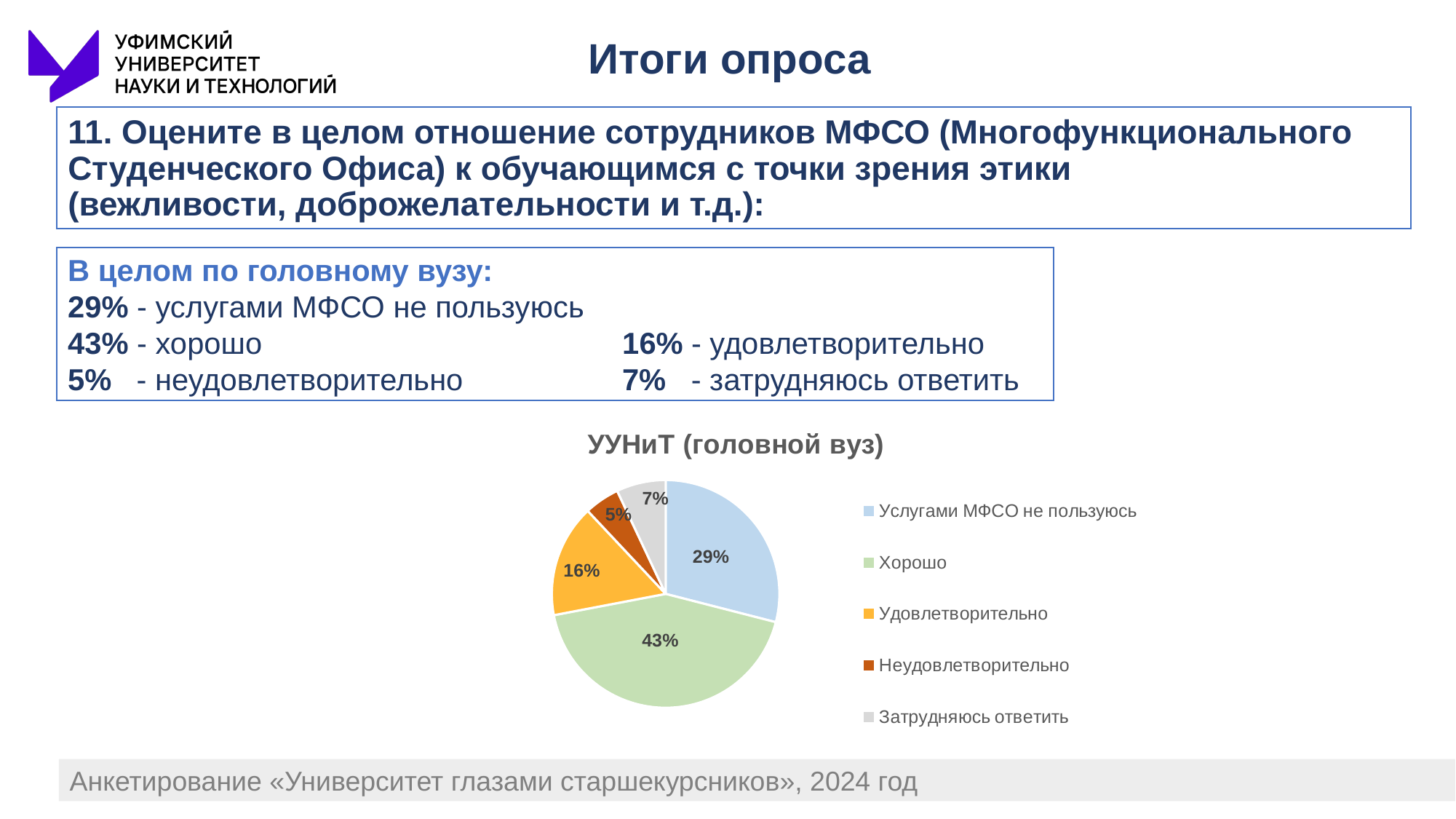
What share of the pie is labelled "Неудовлетворительно"? 5% Which is larger: the share for "Удовлетворительно" or for "Затрудняюсь ответить"? Удовлетворительно What kind of chart is shown on the slide? pie chart Which category has the smallest slice of the pie? Неудовлетворительно What share of the pie is labelled "Удовлетворительно"? 16% How many categories does the legend list? 5 Which category has the largest slice of the pie? Хорошо What share of the pie is labelled "Хорошо"? 43% What share of the pie is labelled "Затрудняюсь ответить"? 7% What share of the pie is labelled "Услугами МФСО не пользуюсь"? 29% What is the difference between the shares for "Хорошо" and "Услугами МФСО не пользуюсь"? 14% What is the chart's title? УУНиТ (головной вуз)